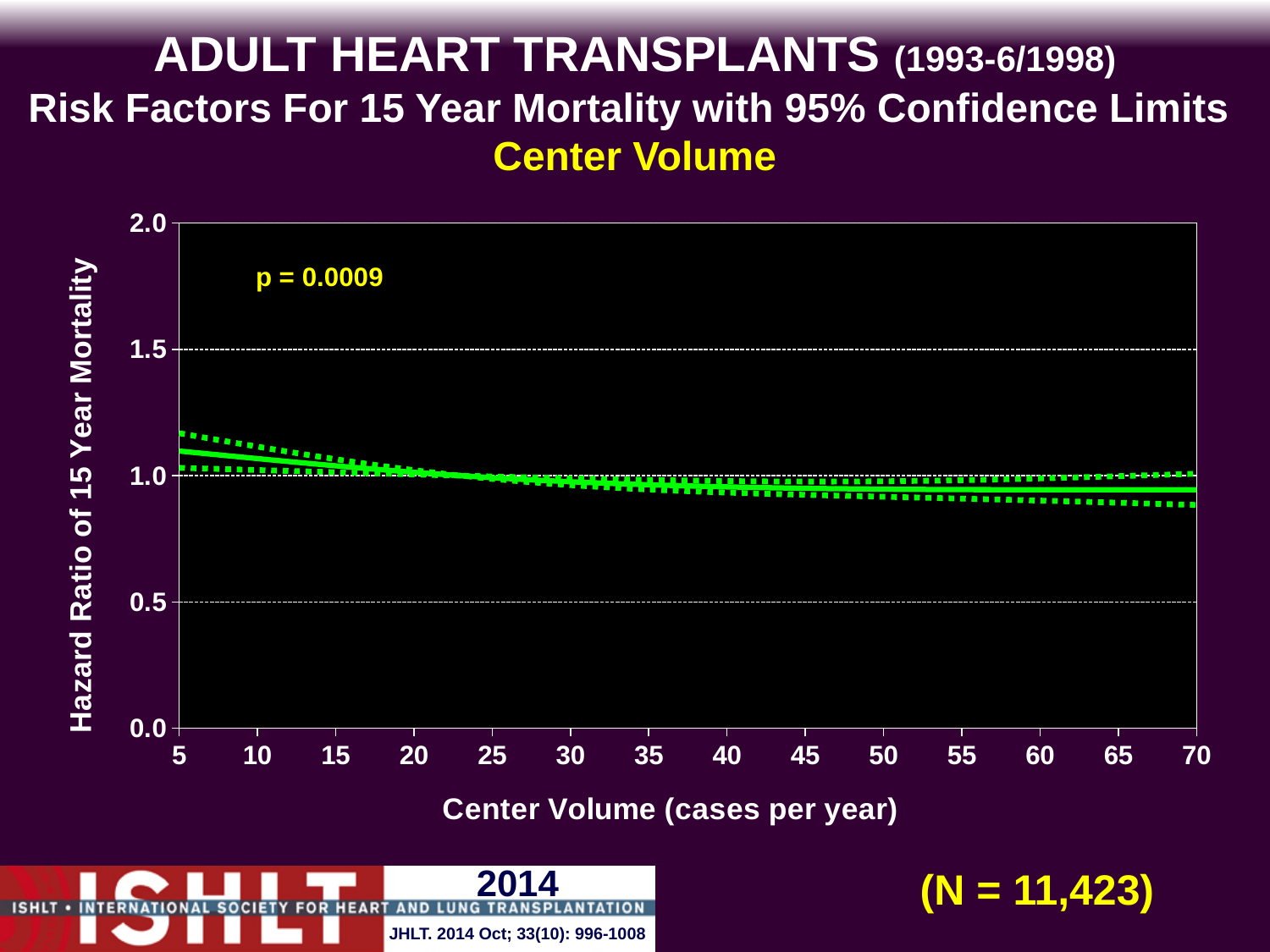
What is the p-value shown on the chart? p = 0.0009 Does the solid hazard ratio line rise or fall as center volume increases from 5 to 70 cases per year? fall How many tick marks are labeled on the x axis? 14 Is the hazard ratio (solid line) higher at a center volume of 5 or at a center volume of 70 cases per year? 5 Is the hazard ratio (solid line) at a center volume of 70 cases per year greater or less than 1.0? less Is the upper confidence limit at a center volume of 5 cases per year greater or less than 1.5? less Is the lower confidence limit at a center volume of 70 cases per year greater or less than 0.5? greater What kind of chart is shown on the slide? line chart What is the label of the x axis? Center Volume (cases per year) What is the highest value labeled on the y axis? 2.0